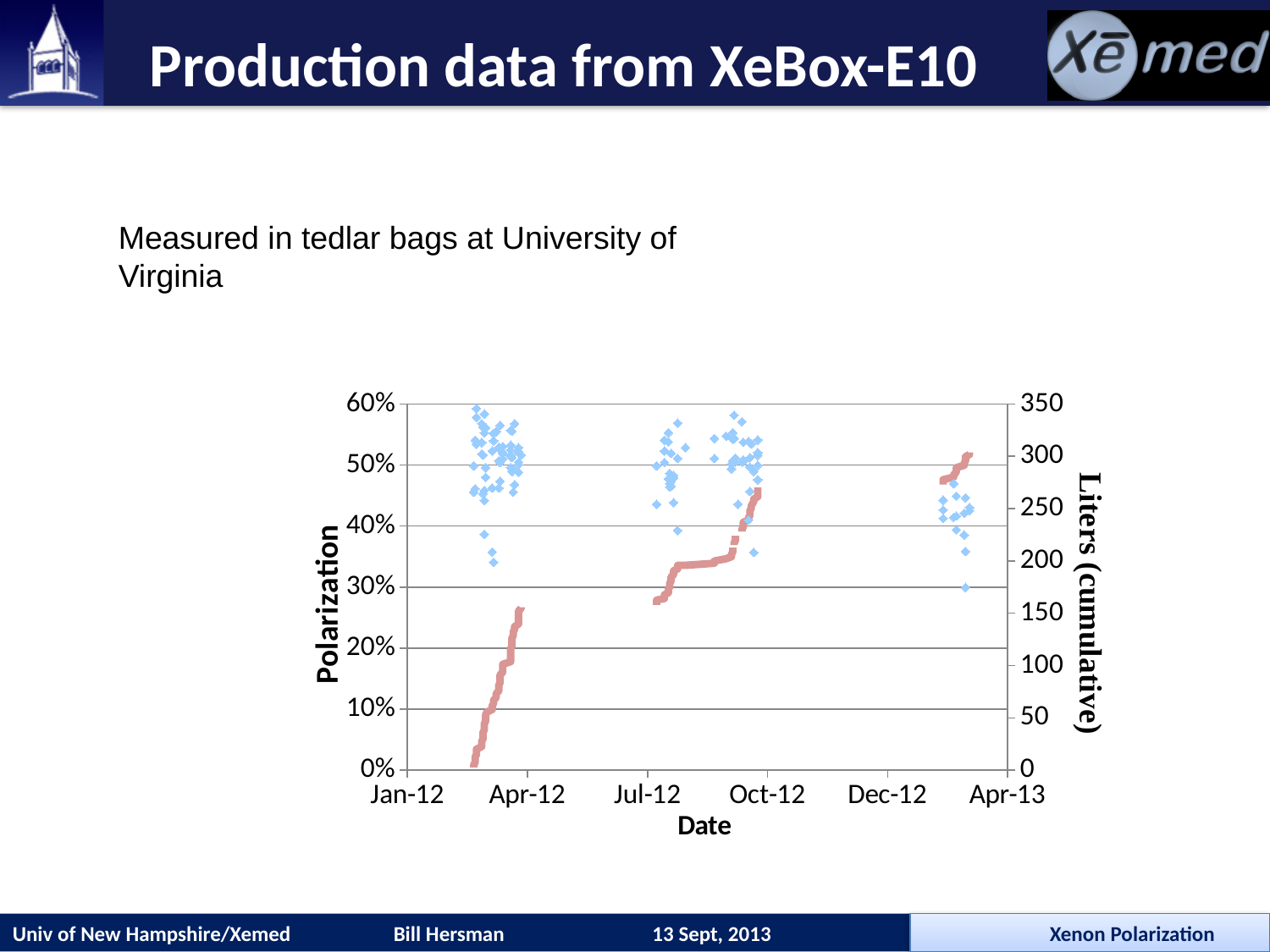
Is the lowest polarization point in the Apr-13 cluster greater or less than 40%? less Is the final cumulative liters value near Apr-13 greater or less than 250? greater Are most polarization points in the Apr-12 cluster greater or less than 40%? greater How many date labels are shown on the x axis? 6 What is the maximum value shown on the left vertical axis? 60% What is the title of the right vertical axis? Liters (cumulative) What is the maximum value shown on the right vertical axis? 350 Does the cumulative liters series rise or fall along the x axis? rise What is the title of the left vertical axis? Polarization What kind of chart is shown on the slide? scatter chart